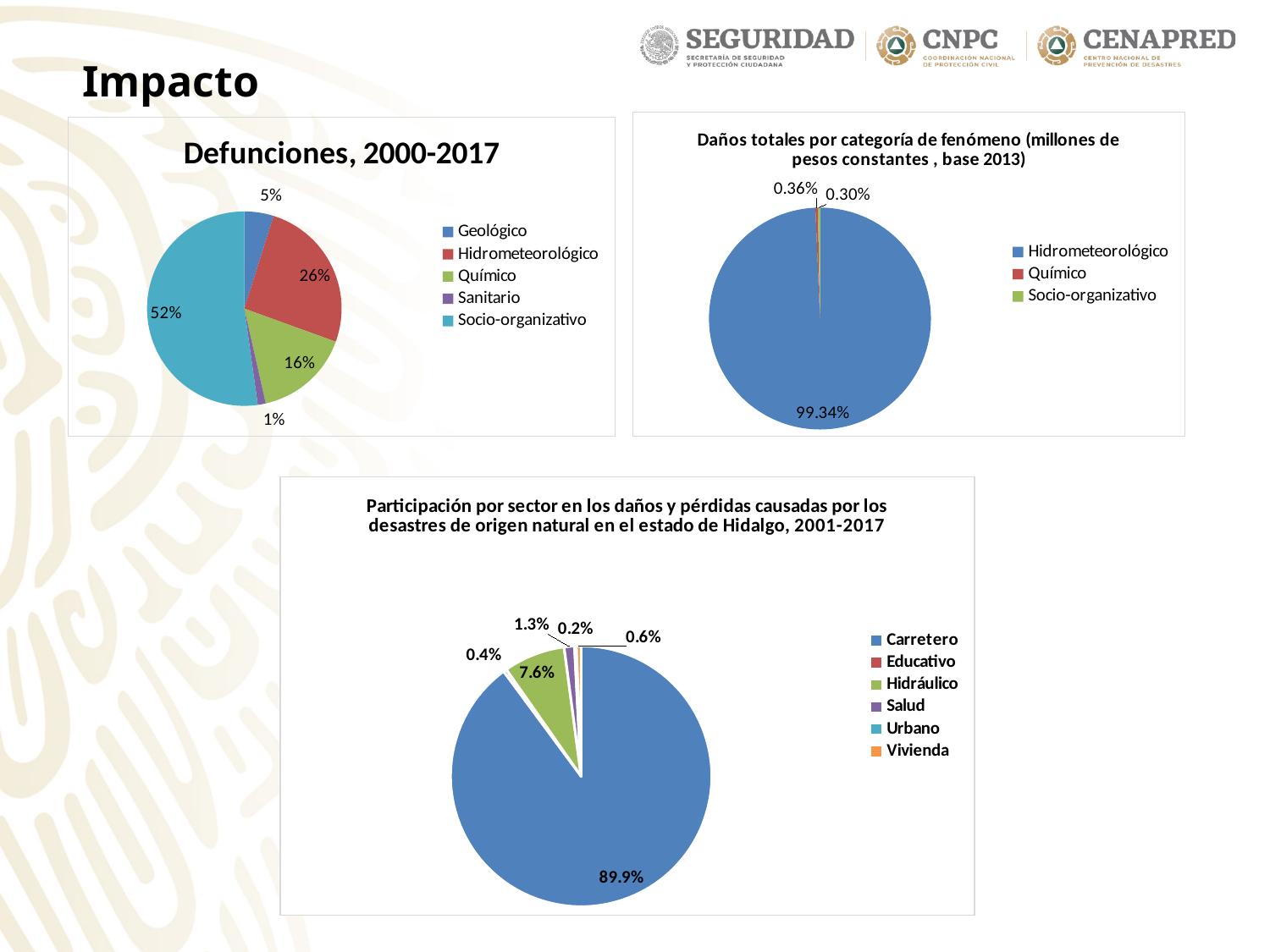
What type of chart is the 'Participación por sector' chart at the bottom of the slide? Pie chart In the 'Defunciones, 2000-2017' chart, what share of deaths is attributed to Socio-organizativo? 52% In the 'Participación por sector' chart at the bottom, what share corresponds to Hidráulico? 7.6% In the 'Daños totales por categoría de fenómeno' chart, what share corresponds to Hidrometeorológico? 99.34% In the 'Defunciones, 2000-2017' chart, what percentage corresponds to Hidrometeorológico? 26% In the 'Participación por sector' chart at the bottom, what share corresponds to Carretero? 89.9% In the 'Defunciones, 2000-2017' chart, which category has the smallest share? Sanitario In the 'Defunciones, 2000-2017' chart, which category has the largest share? Socio-organizativo How many categories does the legend of the 'Defunciones, 2000-2017' chart list? 5 In the 'Defunciones, 2000-2017' chart, what is the difference in percentage points between Hidrometeorológico and Químico? 10 In the 'Daños totales por categoría de fenómeno' chart, which category accounts for the largest share? Hidrometeorológico How many categories does the legend of the 'Daños totales por categoría de fenómeno' chart list? 3